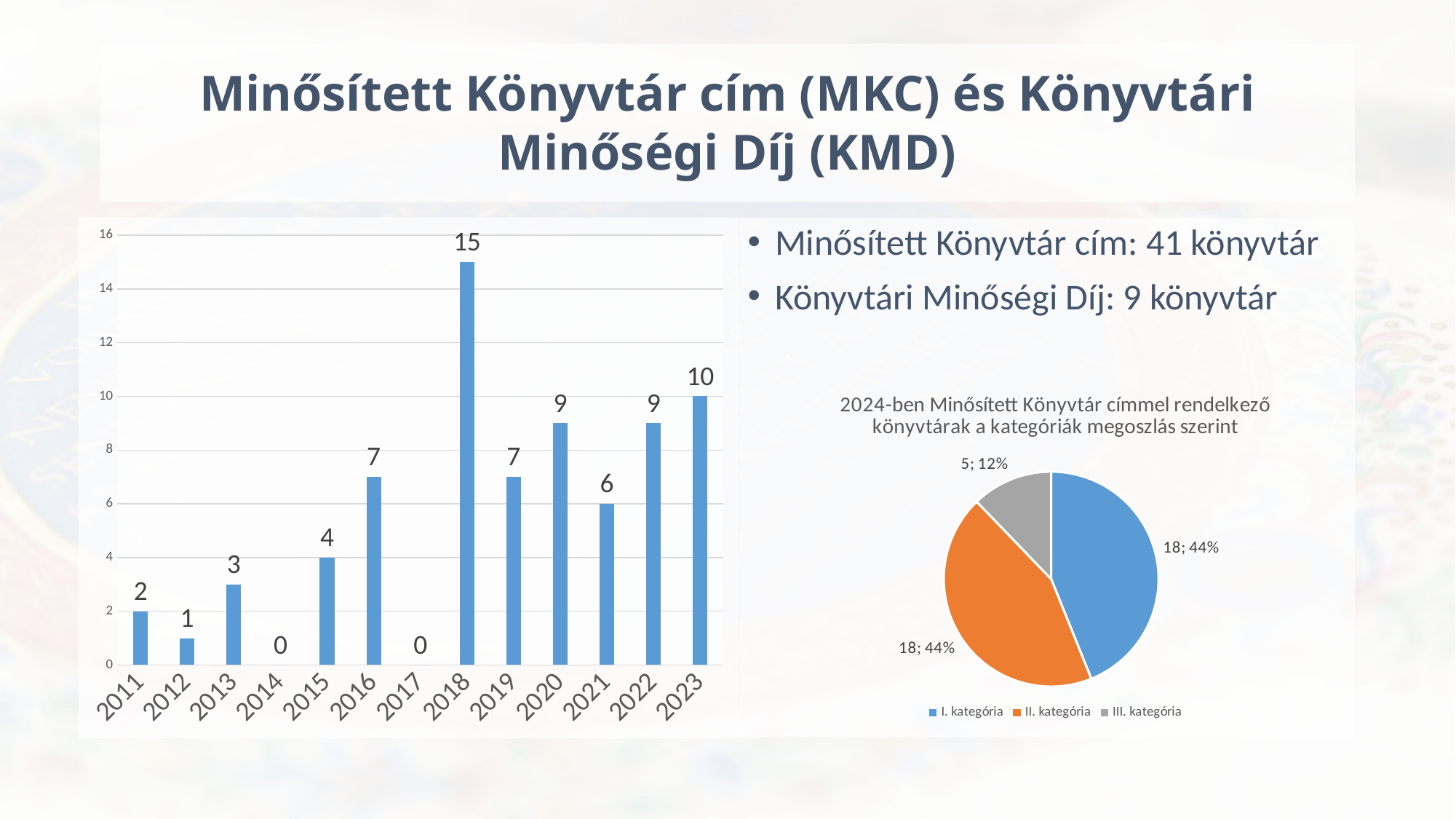
In the pie chart on the right, what share does III. kategória have? 12% In the bar chart on the left, how many years have a value of 0? 2 In the bar chart on the left, what is the value for 2018? 15 In the bar chart on the left, which year has the highest value? 2018 What kind of chart is the chart on the left? bar chart In the pie chart on the right, what is the value for I. kategória? 18 In the bar chart on the left, what is the difference between the values for 2018 and 2023? 5 In the bar chart on the left, what is the value for 2023? 10 In the bar chart on the left, which is larger, the value for 2016 or the value for 2021? 2016 In the bar chart on the left, how many years are shown on the x axis? 13 How many entries does the legend of the pie chart on the right list? 3 In the pie chart on the right, which category has the smallest slice? III. kategória